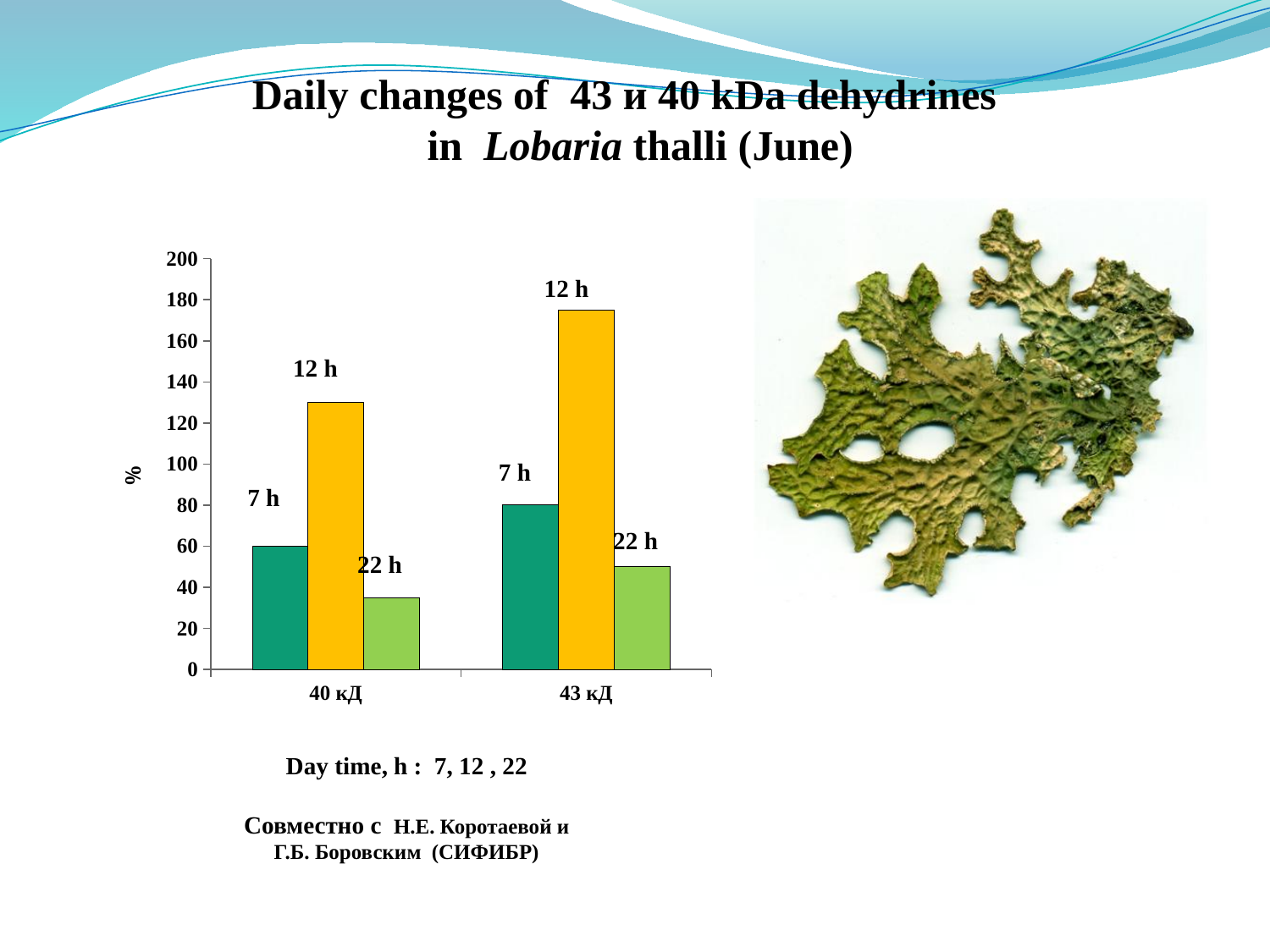
Which is larger, the 12 h value for 40 кД or the 12 h value for 43 кД? 43 кД Is the 12 h value for 43 кД greater or less than 160? greater Is the 12 h value for 40 кД greater or less than 120? greater What is the value of the 7 h bar for 40 кД? 60 What is the difference between the 7 h values for 43 кД and 40 кД? 20 How many categories are shown on the x axis? 2 What is the value of the 7 h bar for 43 кД? 80 What kind of chart is shown on the slide? bar chart Is the 22 h value for 40 кД greater or less than 40? less What is the label of the y axis? % Which bar is the highest in the chart? 12 h for 43 кД Which bar is the lowest in the chart? 22 h for 40 кД